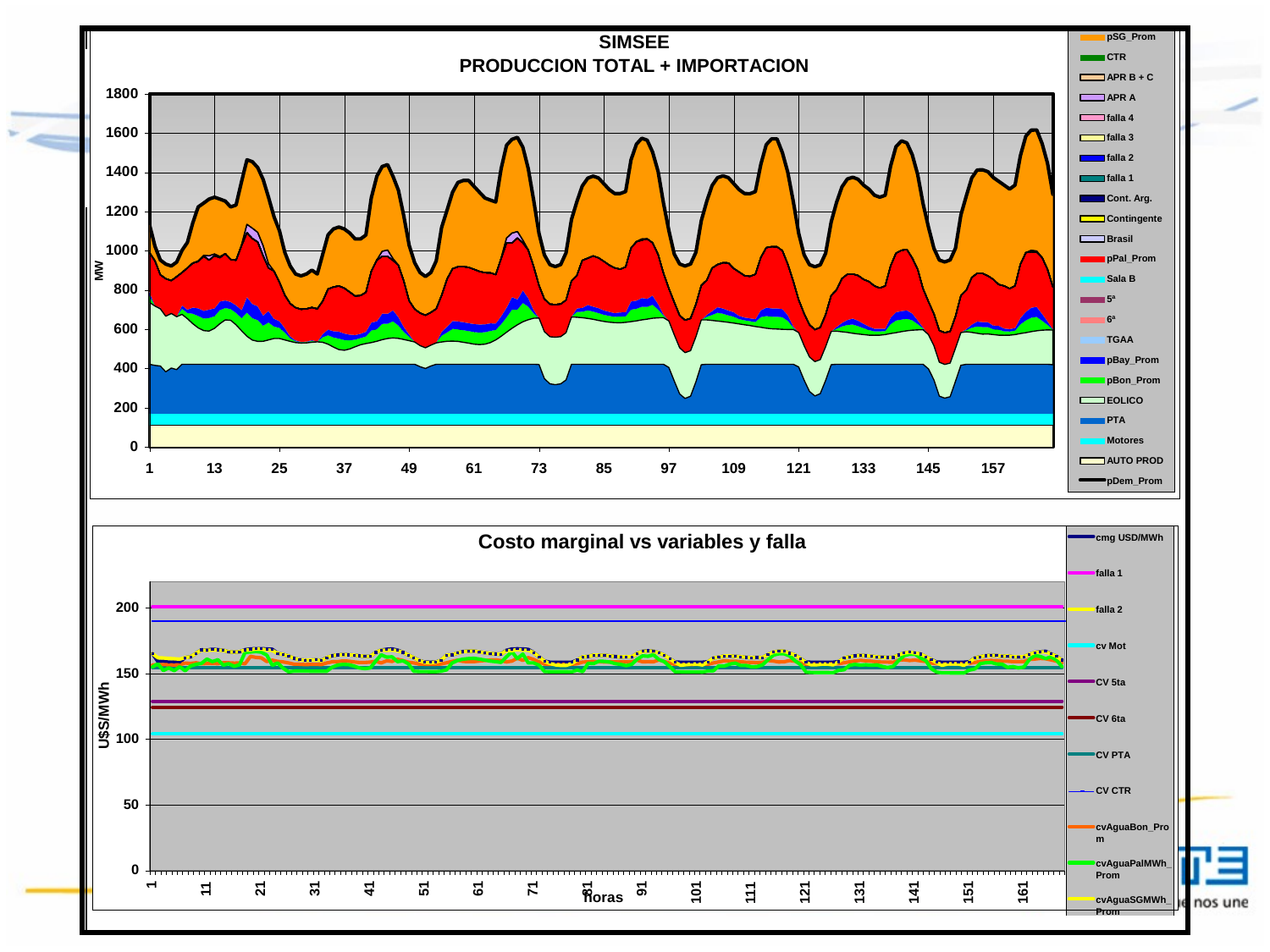
In the bottom chart 'Costo marginal vs variables y falla', is the cmg USD/MWh line greater or less than 200 across the hours shown? less In the bottom chart 'Costo marginal vs variables y falla', what kind of chart is it? line chart In the top chart 'SIMSEE PRODUCCION TOTAL + IMPORTACION', is the highest peak of the pDem_Prom line greater or less than 1400? greater How many series does the legend of the top chart 'SIMSEE PRODUCCION TOTAL + IMPORTACION' list? 23 In the top chart 'SIMSEE PRODUCCION TOTAL + IMPORTACION', is the top of the AUTO PROD band greater or less than 200? less What is the title of the top chart? SIMSEE PRODUCCION TOTAL + IMPORTACION In the bottom chart 'Costo marginal vs variables y falla', which line is higher: falla 1 or cv Mot? falla 1 In the top chart 'SIMSEE PRODUCCION TOTAL + IMPORTACION', what kind of chart is it? stacked area chart What is the title of the bottom chart? Costo marginal vs variables y falla How many series does the legend of the bottom chart 'Costo marginal vs variables y falla' list? 11